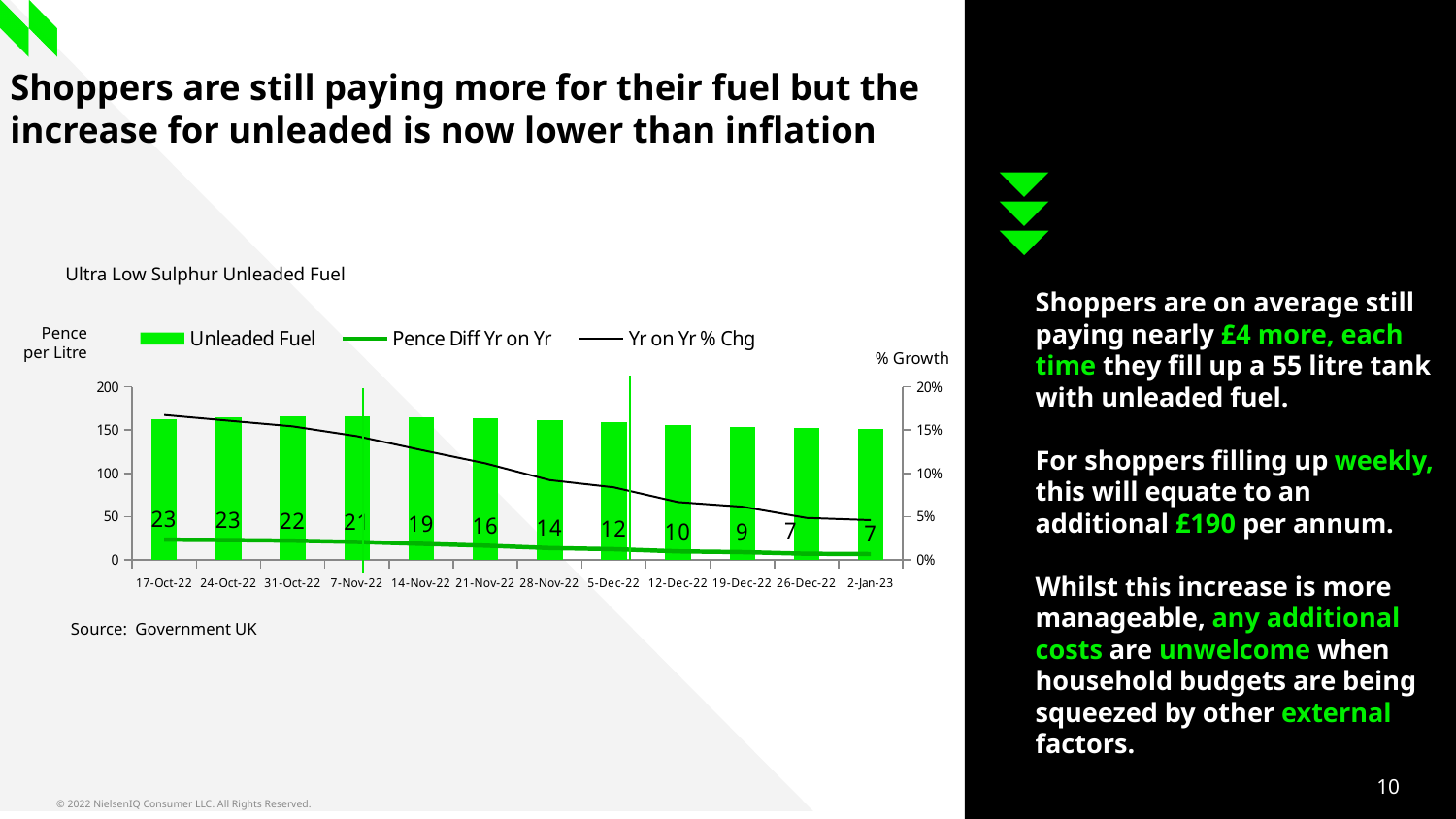
Does the Yr on Yr % Chg line rise or fall from 17-Oct-22 to 2-Jan-23? fall What kind of chart is shown on the slide? bar chart with line series What is the Pence Diff Yr on Yr value for 2-Jan-23? 7 What is the difference between the Pence Diff Yr on Yr values for 17-Oct-22 and 2-Jan-23? 16 How many series does the chart legend list? 3 What is the Pence Diff Yr on Yr value for 17-Oct-22? 23 What is the lowest Pence Diff Yr on Yr value labelled on the chart? 7 What is the Pence Diff Yr on Yr value for 21-Nov-22? 16 How many dates are shown on the x axis of the chart? 12 What source is cited below the chart? Government UK Which date has the larger Pence Diff Yr on Yr value, 14-Nov-22 or 12-Dec-22? 14-Nov-22 Is the Unleaded Fuel value for 17-Oct-22 greater or less than 150? greater